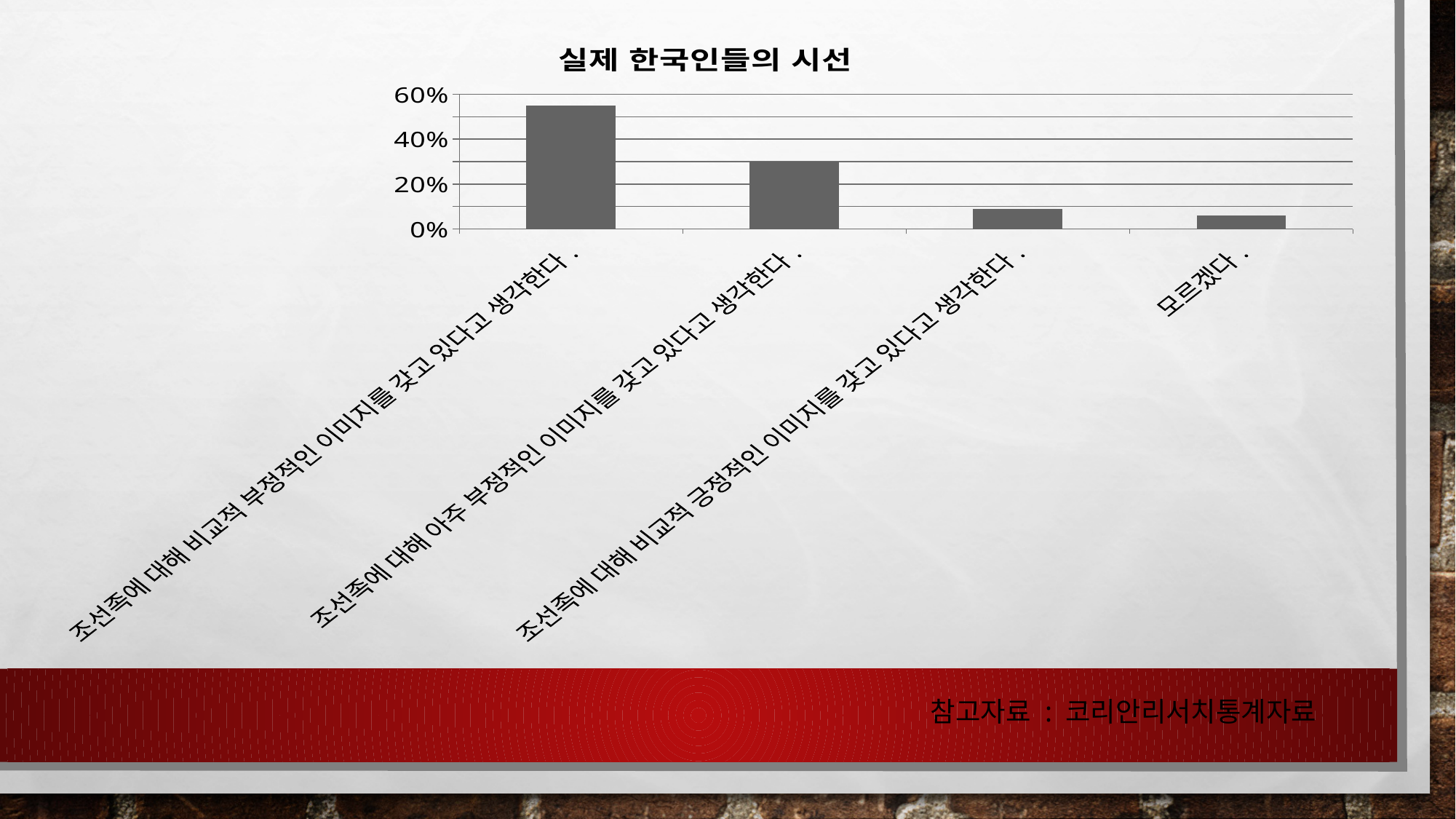
Is the value for '조선족에 대해 아주 부정적인 이미지를 갖고 있다고 생각한다.' greater or less than 20%? greater Which category has the lowest value? 모르겠다. Is the value for '모르겠다.' greater or less than 20%? less How many categories are plotted in the chart? 4 What source is cited at the bottom of the slide for the chart data? 코리안리서치통계자료 Is the value for '조선족에 대해 비교적 긍정적인 이미지를 갖고 있다고 생각한다.' greater or less than 20%? less Which is larger: the value for '조선족에 대해 비교적 부정적인 이미지를 갖고 있다고 생각한다.' or for '조선족에 대해 아주 부정적인 이미지를 갖고 있다고 생각한다.'? 조선족에 대해 비교적 부정적인 이미지를 갖고 있다고 생각한다. What kind of chart is shown on the slide? Bar chart Which category has the highest value? 조선족에 대해 비교적 부정적인 이미지를 갖고 있다고 생각한다. What is the title of the chart? 실제 한국인들의 시선 Do the bar values rise or fall from left to right across the categories? Fall